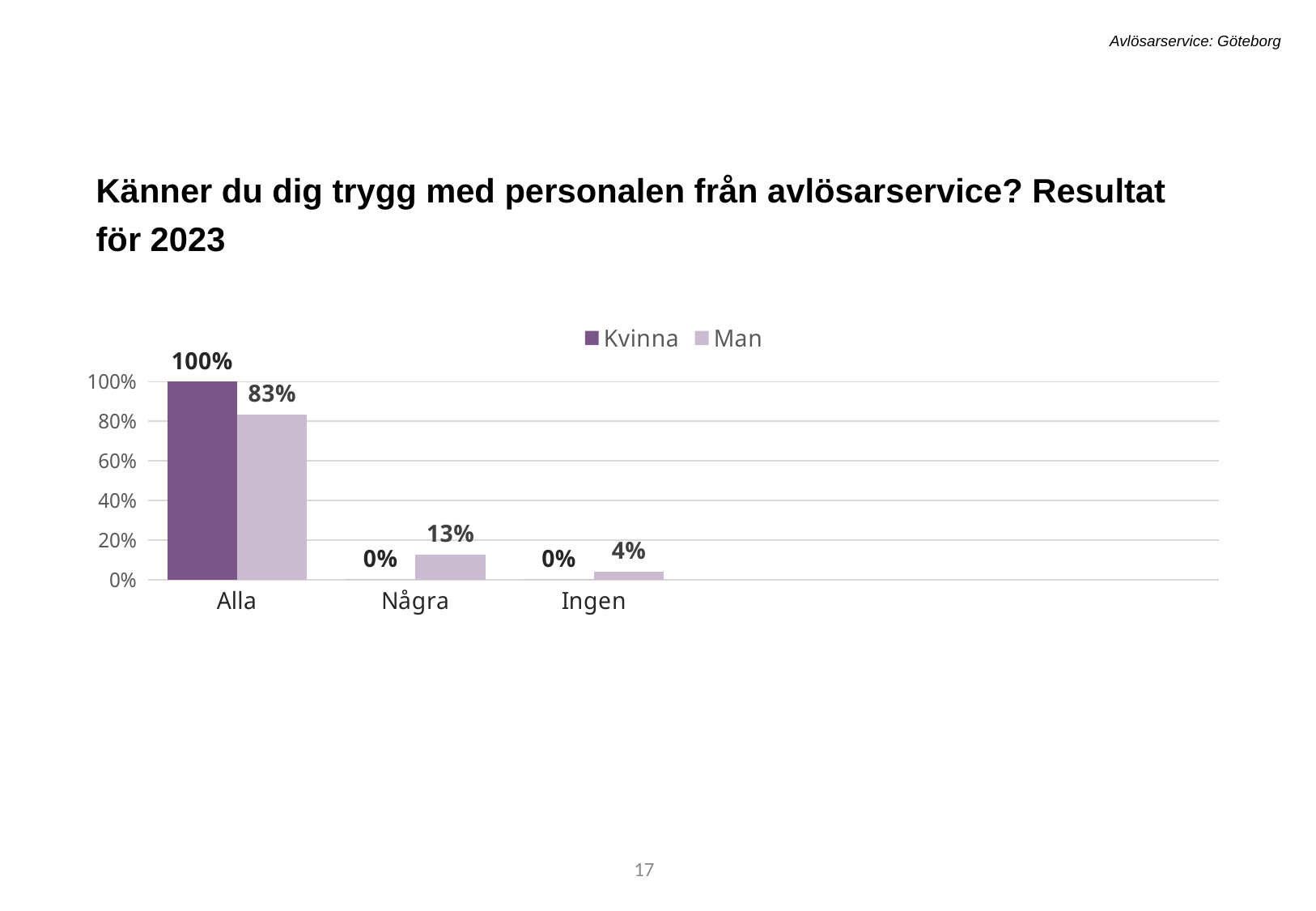
What kind of chart is shown on the slide? Bar chart What is the value for Man in the Alla category? 83% How many series does the legend list? 2 What is the difference between the Kvinna and Man values in the Alla category? 17% Which category has the highest value for Man? Alla What is the value for Man in the Ingen category? 4% Which is larger in the Några category, Kvinna or Man? Man How many categories are shown on the x axis? 3 What is the value for Kvinna in the Alla category? 100% What is the value for Man in the Några category? 13% Which category has the lowest value for Man? Ingen What is the value for Kvinna in the Ingen category? 0%